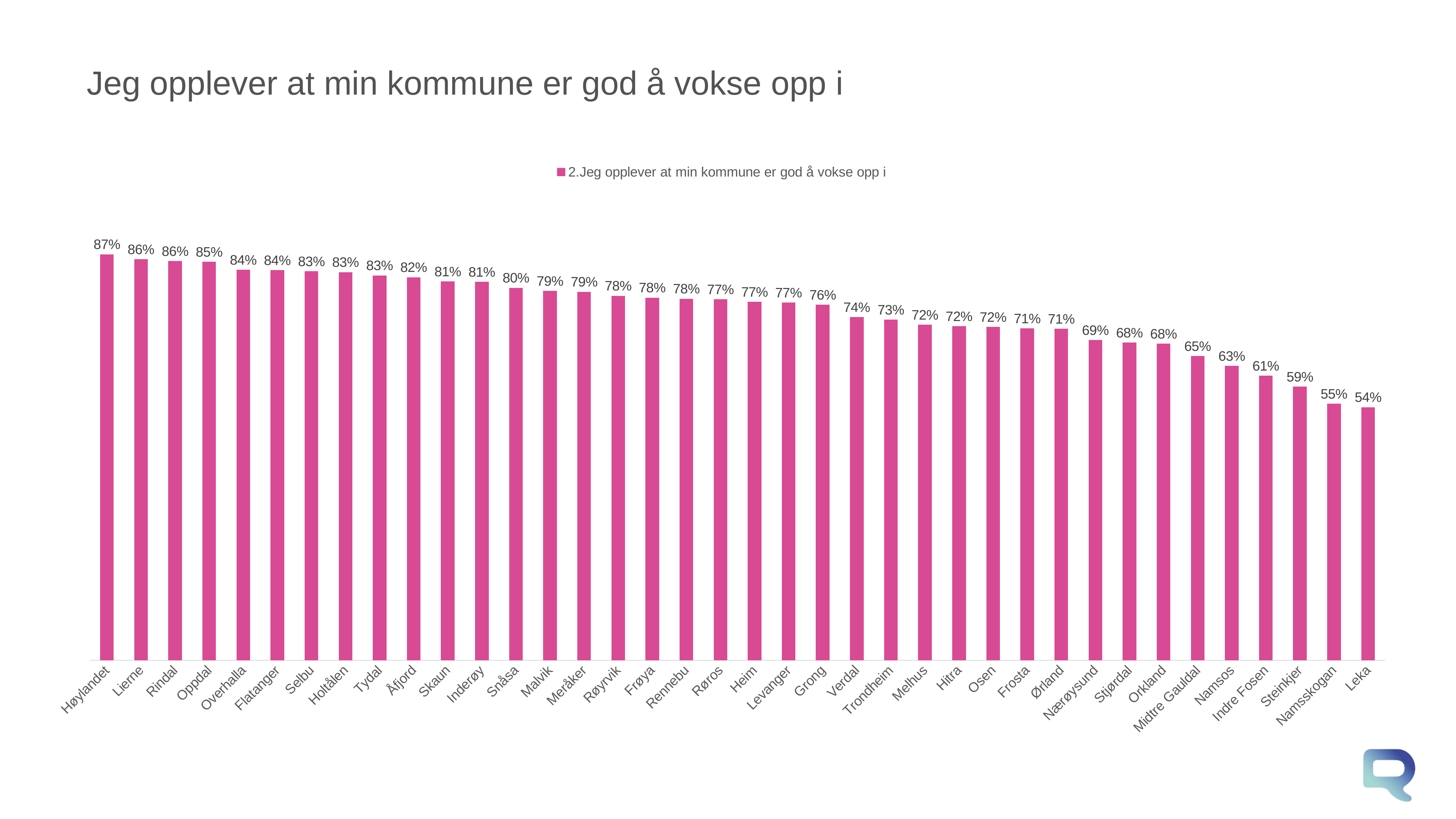
How many series does the legend list? 1 What is the value for Leka? 54% What is the difference between the values for Verdal and Namsos? 11% What is the difference between the values for Høylandet and Leka? 33% Which municipality has the highest value? Høylandet How many municipalities are shown on the x axis? 38 Do the values rise or fall from left to right along the x axis? Fall What kind of chart is shown on the slide? Bar chart Which municipality has the lowest value? Leka What is the value for Trondheim? 73% Which has a larger value, Oppdal or Melhus? Oppdal What is the value for Steinkjer? 59%